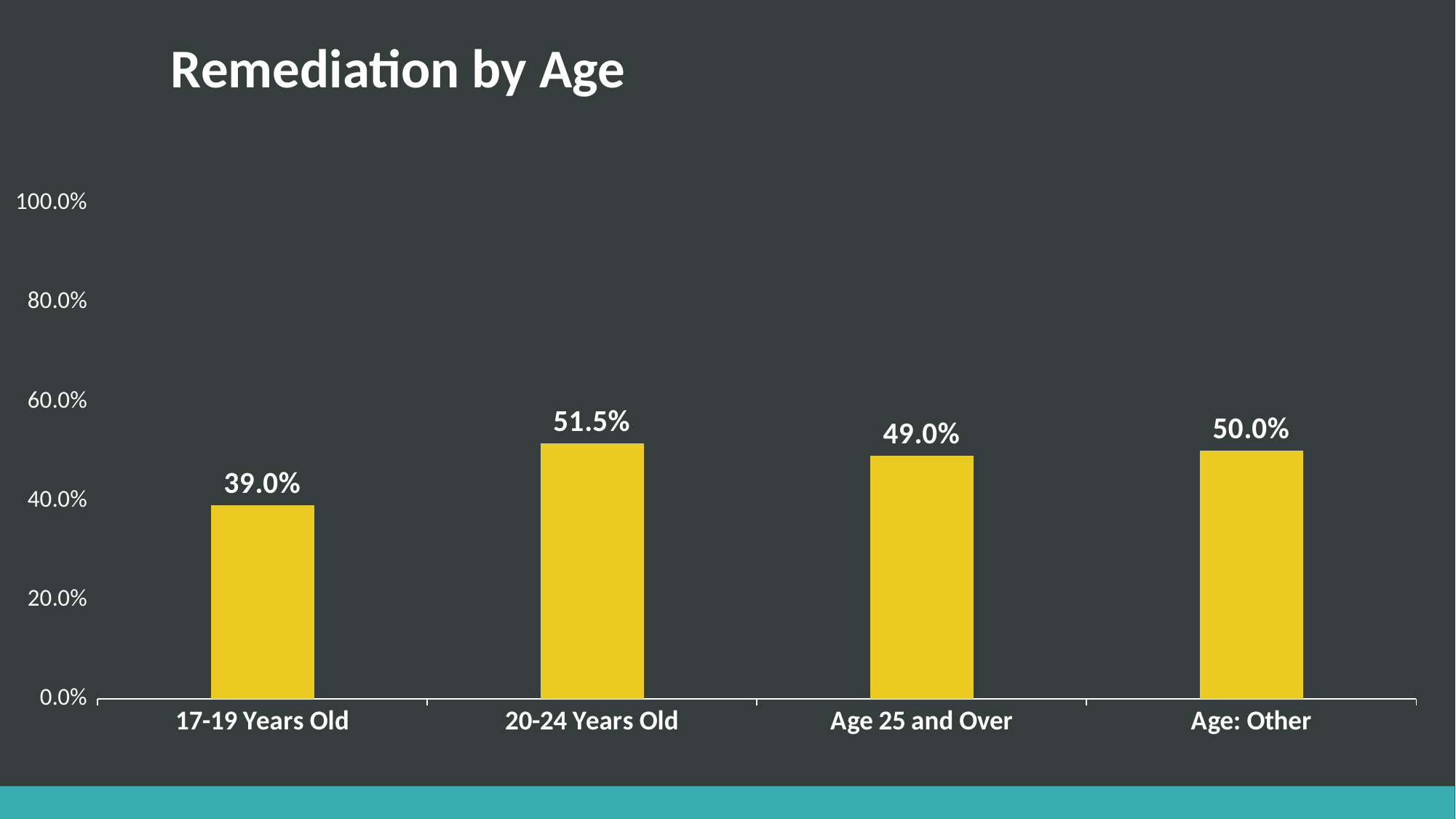
Which age group has the highest remediation rate? 20-24 Years Old Which age group has the lowest remediation rate? 17-19 Years Old What is the remediation rate for 17-19 Years Old? 39.0% How many age categories are shown in the chart? 4 What is the difference between the remediation rates for Age: Other and Age 25 and Over? 1.0% What is the remediation rate for Age: Other? 50.0% What type of chart is shown on the slide? Bar chart Is the value for 20-24 Years Old greater or less than 60.0%? less What is the remediation rate for 20-24 Years Old? 51.5% What is the difference between the remediation rates for 20-24 Years Old and 17-19 Years Old? 12.5% Which has a higher remediation rate, 17-19 Years Old or Age 25 and Over? Age 25 and Over What is the remediation rate for Age 25 and Over? 49.0%